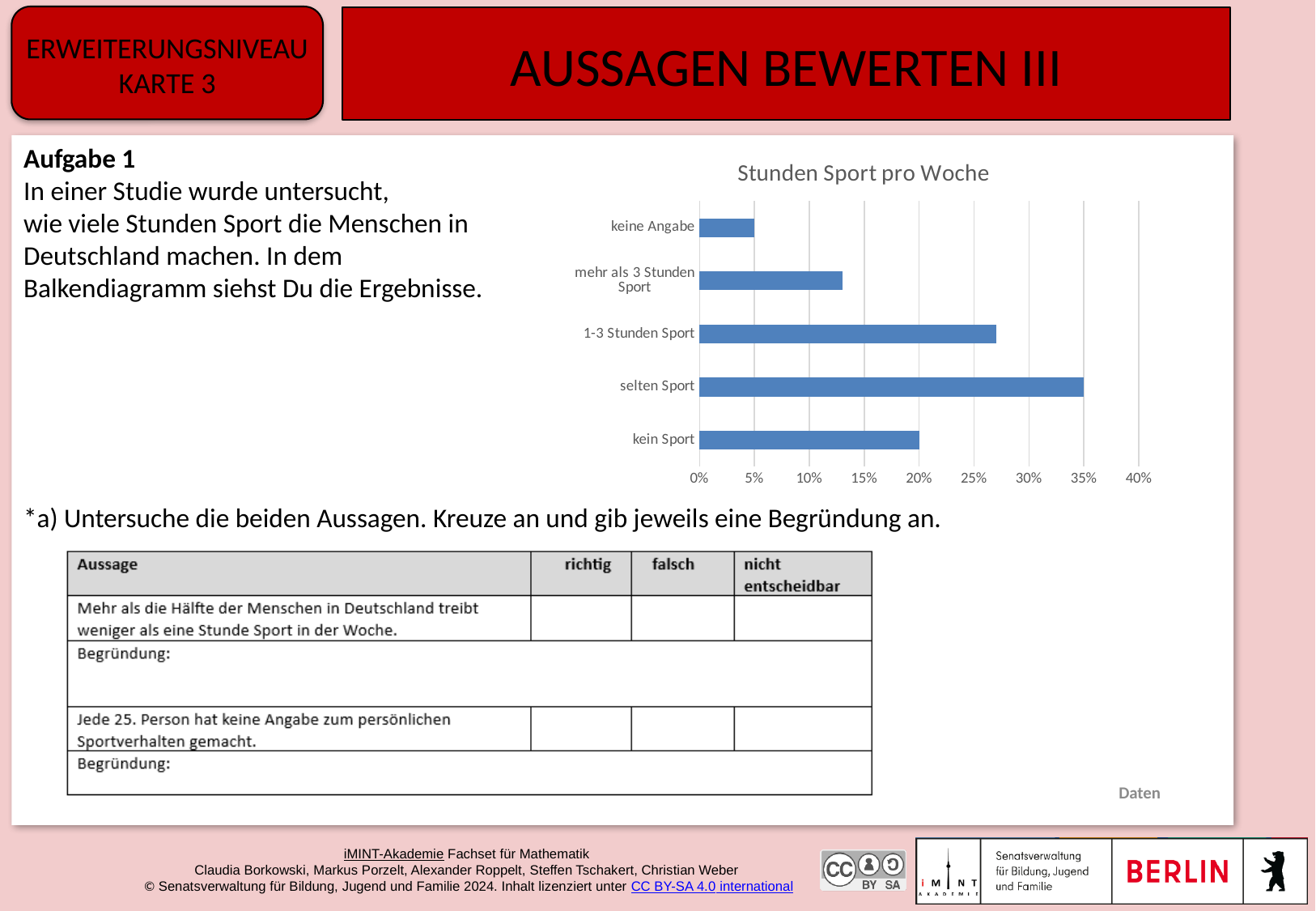
Which category has the lowest value? keine Angabe Which category has the highest value? selten Sport What kind of chart is shown on the slide? bar chart How many categories are shown in the chart? 5 Is the value for 'mehr als 3 Stunden Sport' greater or less than 10%? greater What is the value for 'kein Sport'? 20% What is the value for 'selten Sport'? 35% Which is larger, the value for 'kein Sport' or the value for '1-3 Stunden Sport'? 1-3 Stunden Sport What is the title of the chart? Stunden Sport pro Woche What is the value for 'keine Angabe'? 5% Is the value for '1-3 Stunden Sport' greater or less than 30%? less What is the difference between the values for 'selten Sport' and 'kein Sport'? 15%